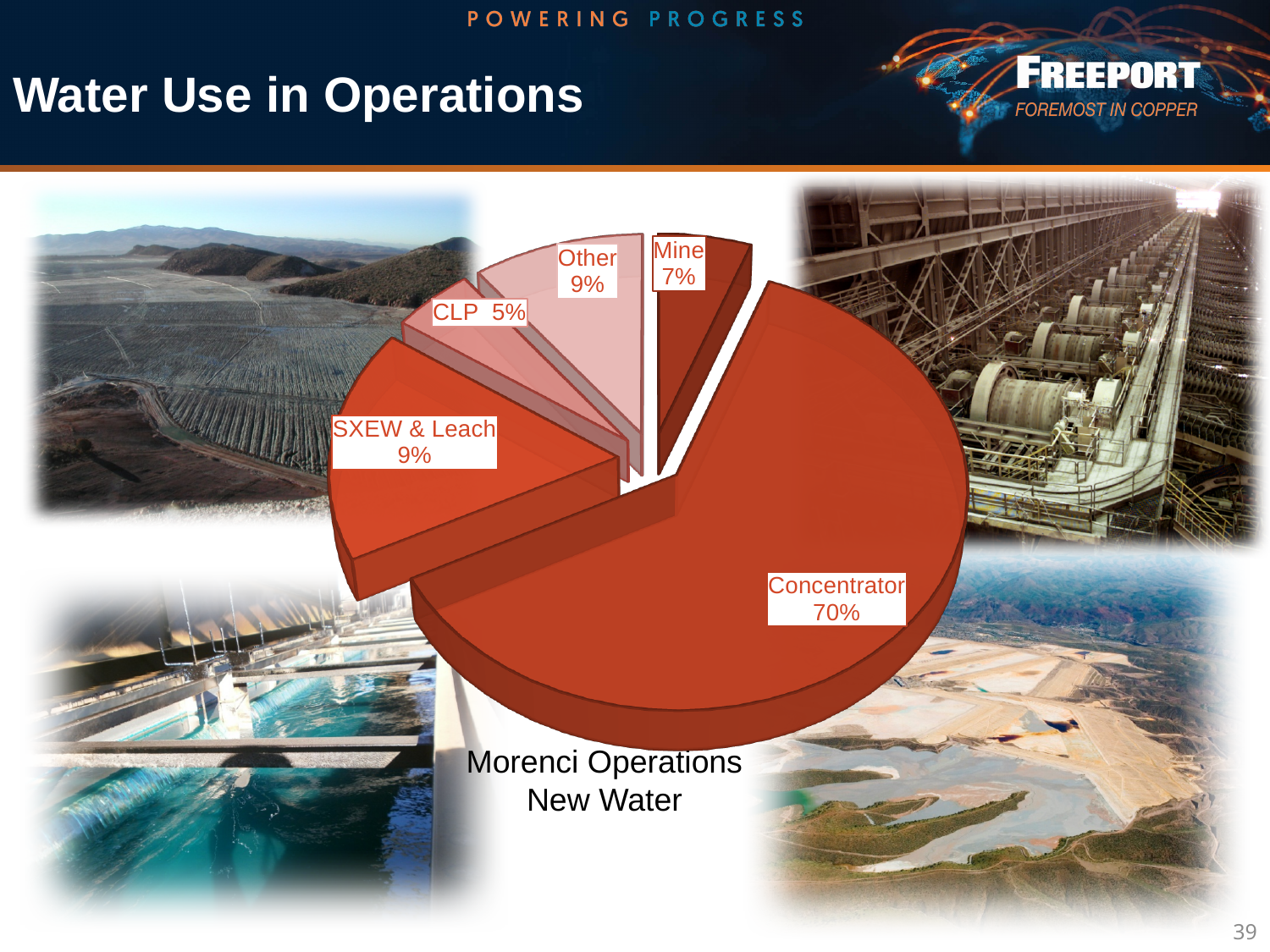
What caption appears below the pie chart? Morenci Operations New Water Which is larger, the Mine share or the CLP share? Mine What percentage of new water is used by the Mine? 7% What share of Morenci Operations new water is used by the Concentrator? 70% What percentage of new water is used by SXEW & Leach? 9% What kind of chart is shown on the slide? pie chart Which category uses the largest share of new water? Concentrator What percentage of new water is attributed to CLP? 5% What is the difference in percentage points between the Concentrator and SXEW & Leach shares? 61 What percentage of new water is attributed to Other? 9% How many categories are shown in the pie chart? 5 Which category uses the smallest share of new water? CLP